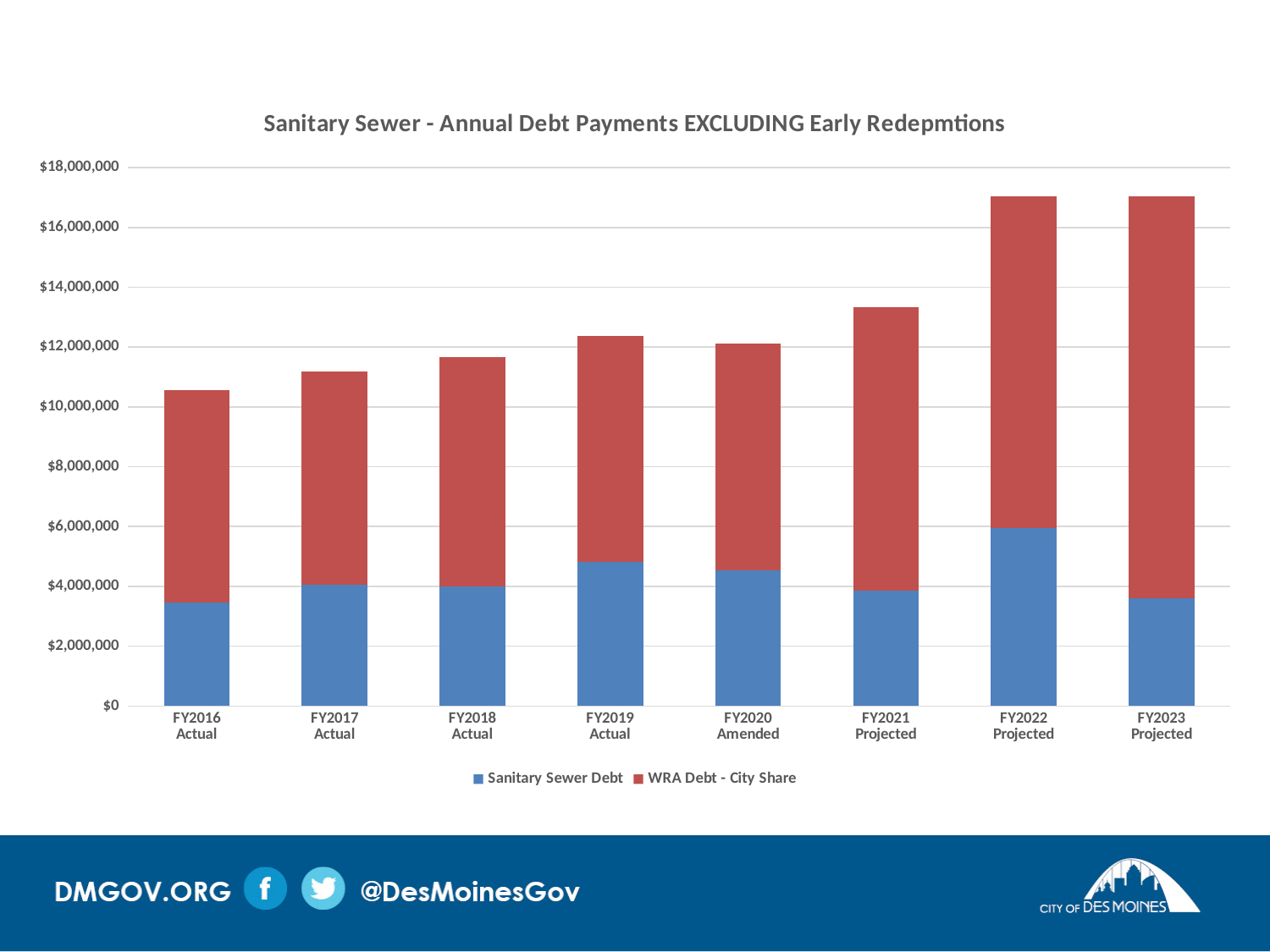
What is the title of the chart? Sanitary Sewer - Annual Debt Payments EXCLUDING Early Redepmtions Which fiscal year has the lowest total annual debt payment? FY2016 Actual Which has the larger total annual debt payment, FY2018 Actual or FY2021 Projected? FY2021 Projected How many fiscal year categories are shown on the x axis? 8 Is the total annual debt payment for FY2021 Projected greater or less than $14,000,000? less Which fiscal year has the highest Sanitary Sewer Debt value? FY2022 Projected What kind of chart is shown on the slide? Stacked bar chart Which series is shown in red? WRA Debt - City Share Is the total annual debt payment for FY2022 Projected greater or less than $16,000,000? greater How many series does the legend list? 2 Is the total annual debt payment for FY2016 Actual greater or less than $10,000,000? greater